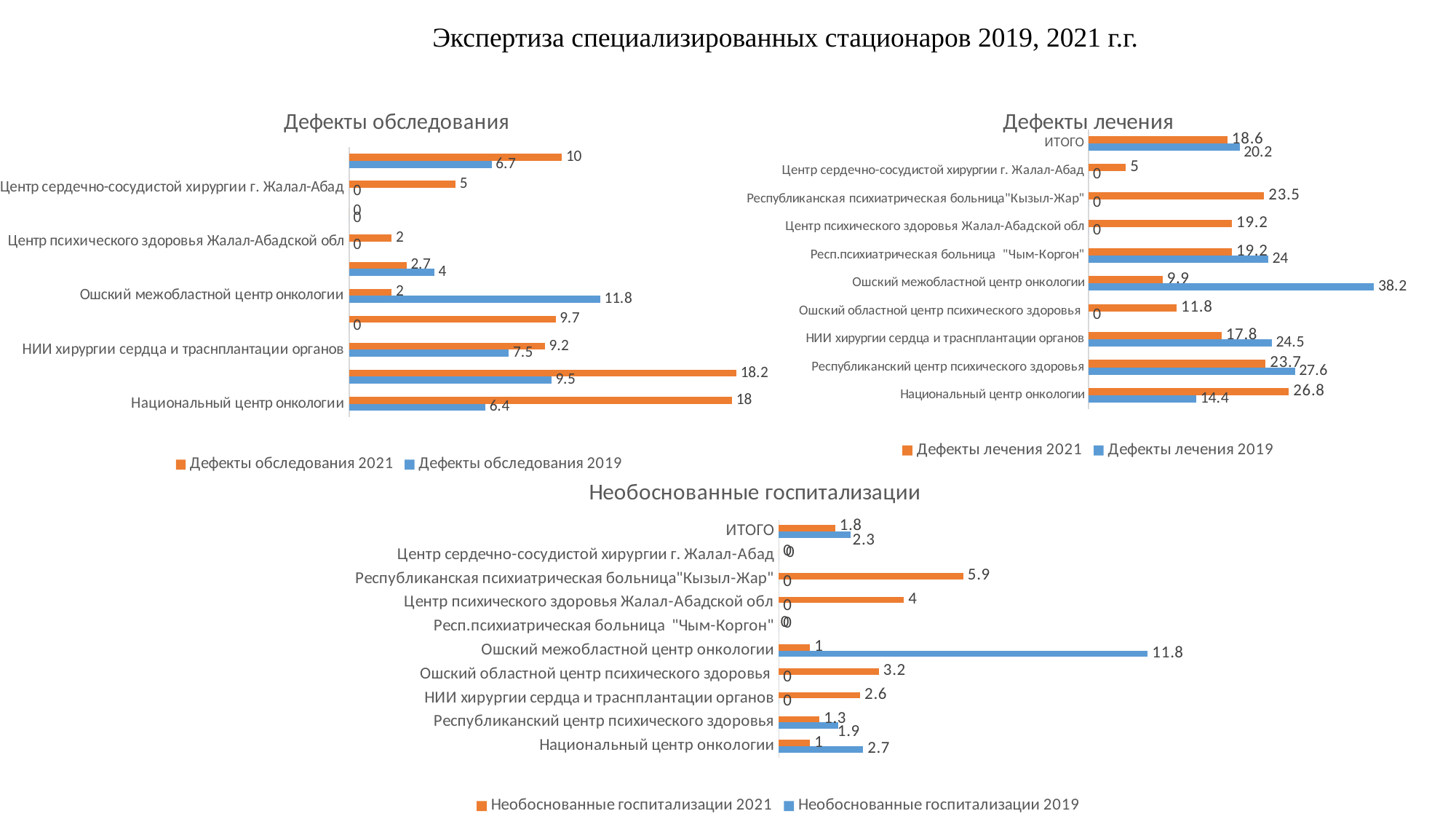
What kind of chart is 'Дефекты обследования'? Bar chart In the 'Дефекты лечения' chart, what is the 'Дефекты лечения 2019' value for Ошский межобластной центр онкологии? 38.2 In the 'Дефекты лечения' chart, what is the difference between the 2019 and 2021 values for ИТОГО? 1.6 In the 'Дефекты лечения' chart, which category has the highest 'Дефекты лечения 2019' value? Ошский межобластной центр онкологии How many series does the legend of the 'Дефекты лечения' chart list? 2 In the 'Дефекты лечения' chart, what is the difference between the 2019 and 2021 values for НИИ хирургии сердца и трансплантации органов? 6.7 In the 'Необоснованные госпитализации' chart, for Национальный центр онкологии, which is larger: the 2019 value or the 2021 value? 2019 In the 'Необоснованные госпитализации' chart, which category has the highest 'Необоснованные госпитализации 2021' value? Республиканская психиатрическая больница "Кызыл-Жар" In the 'Дефекты лечения' chart, what is the 'Дефекты лечения 2021' value for Национальный центр онкологии? 26.8 In the 'Необоснованные госпитализации' chart, what is the 2021 value for Республиканская психиатрическая больница "Кызыл-Жар"? 5.9 In the 'Необоснованные госпитализации' chart, what is the 2019 value for Ошский межобластной центр онкологии? 11.8 How many categories are shown in the 'Необоснованные госпитализации' chart? 10